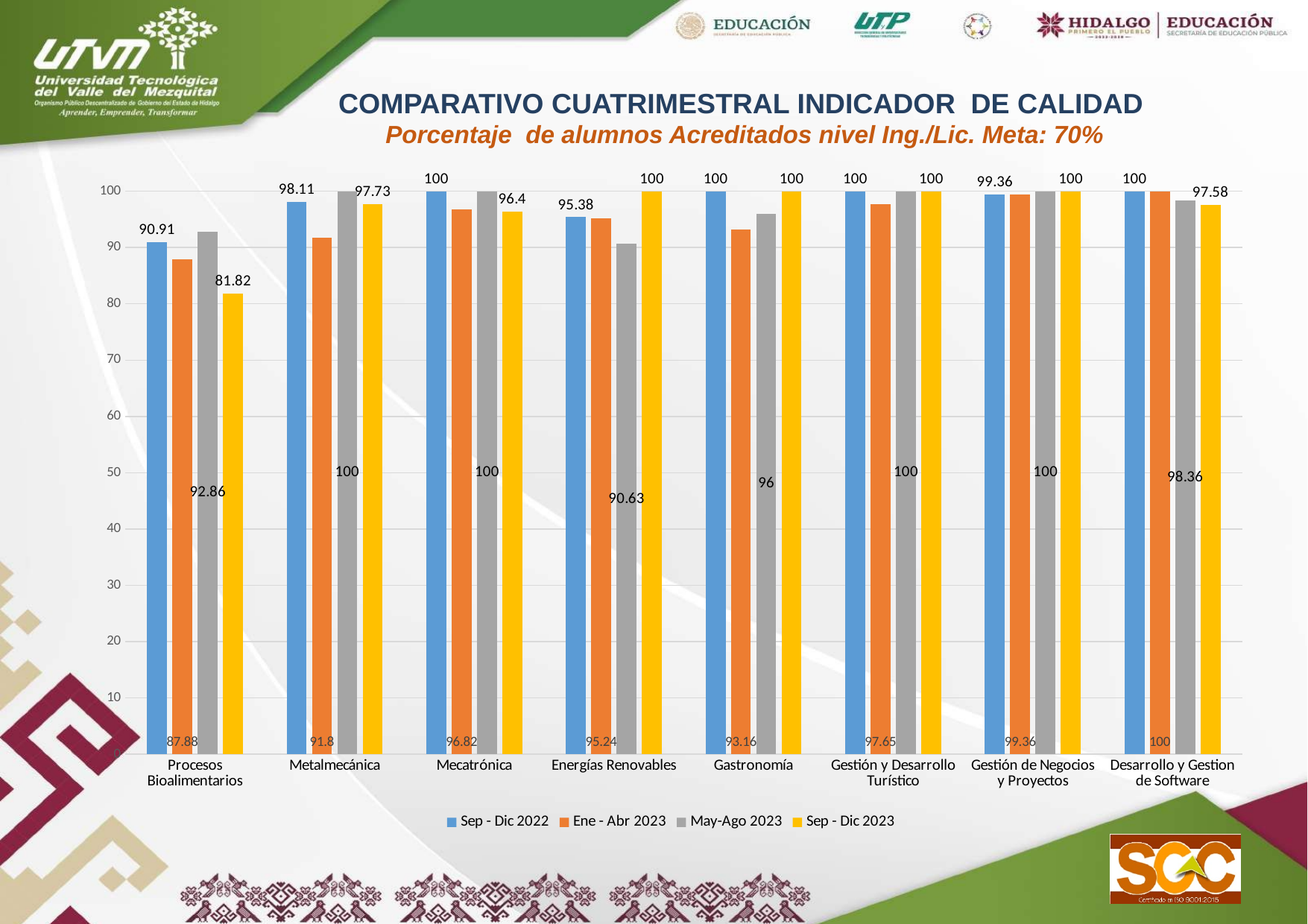
What is the value for Gastronomía in the Ene - Abr 2023 series? 93.16 How many series does the legend list? 4 How many categories (programs) are shown on the x axis? 8 What is the value for Procesos Bioalimentarios in the Sep - Dic 2023 series? 81.82 What target (Meta) is stated in the chart subtitle? 70% In the Sep - Dic 2023 series, which is larger: Metalmecánica or Mecatrónica? Metalmecánica For Procesos Bioalimentarios, what is the difference between the Sep - Dic 2022 value and the Sep - Dic 2023 value? 9.09 Is the Sep - Dic 2023 value for Procesos Bioalimentarios greater or less than 90? less Which category has the lowest value in the Sep - Dic 2023 series? Procesos Bioalimentarios What is the value for Metalmecánica in the Sep - Dic 2022 series? 98.11 What is the value for Energías Renovables in the May-Ago 2023 series? 90.63 What kind of chart is shown on the slide? bar chart